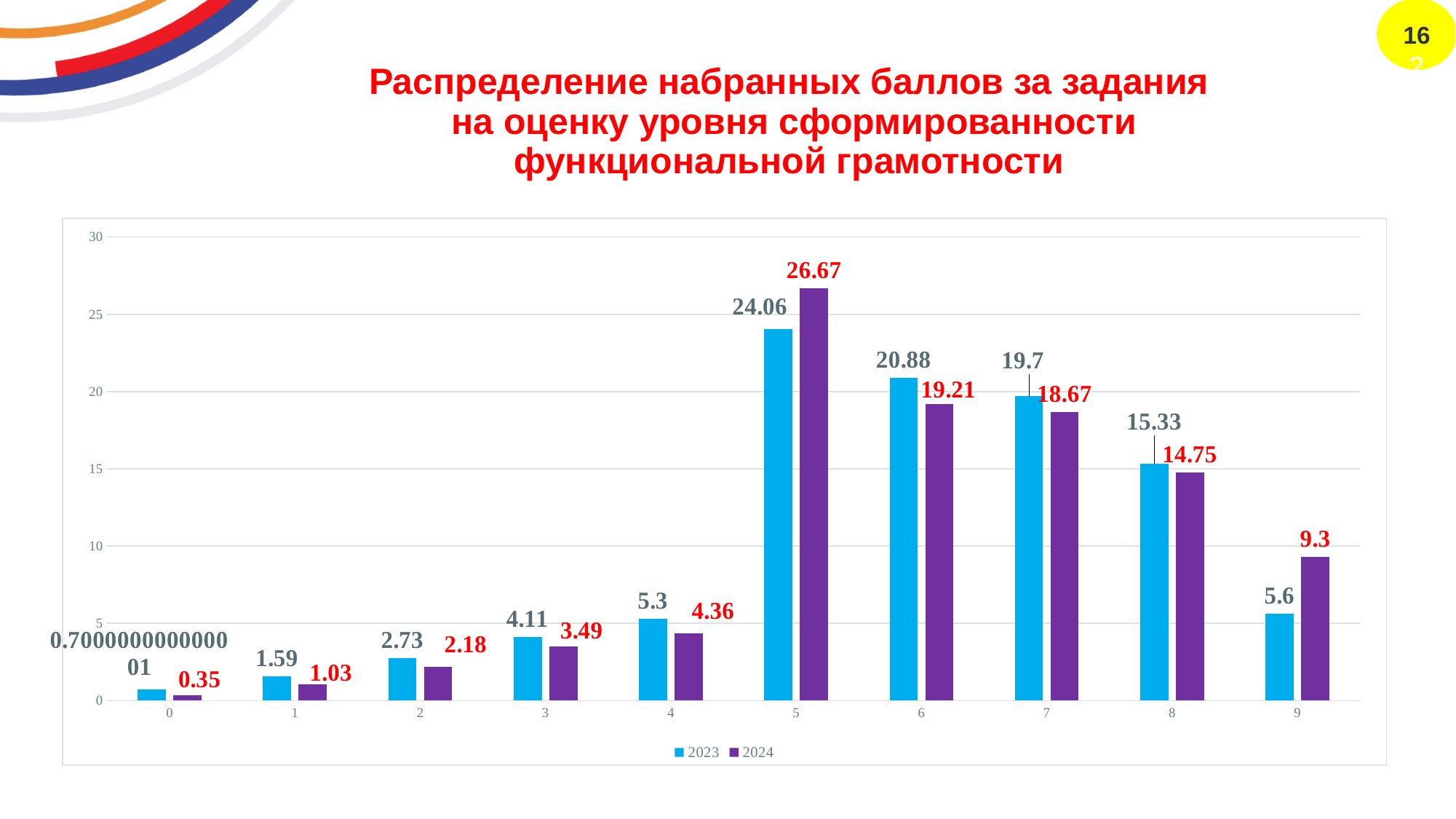
How many series does the legend list? 2 What is the difference between the 2024 and 2023 values for category 5? 2.61 What is the value for category 6 in the 2023 series? 20.88 What kind of chart is shown on the slide? bar chart How many categories are shown on the x axis? 10 Which category has the highest value in the 2023 series? 5 For category 9, which series has the larger value, 2023 or 2024? 2024 Is the 2023 value for category 7 greater or less than 15? greater What is the value for category 3 in the 2023 series? 4.11 Which category has the lowest value in the 2024 series? 0 What is the value for category 5 in the 2024 series? 26.67 What is the value for category 9 in the 2024 series? 9.3